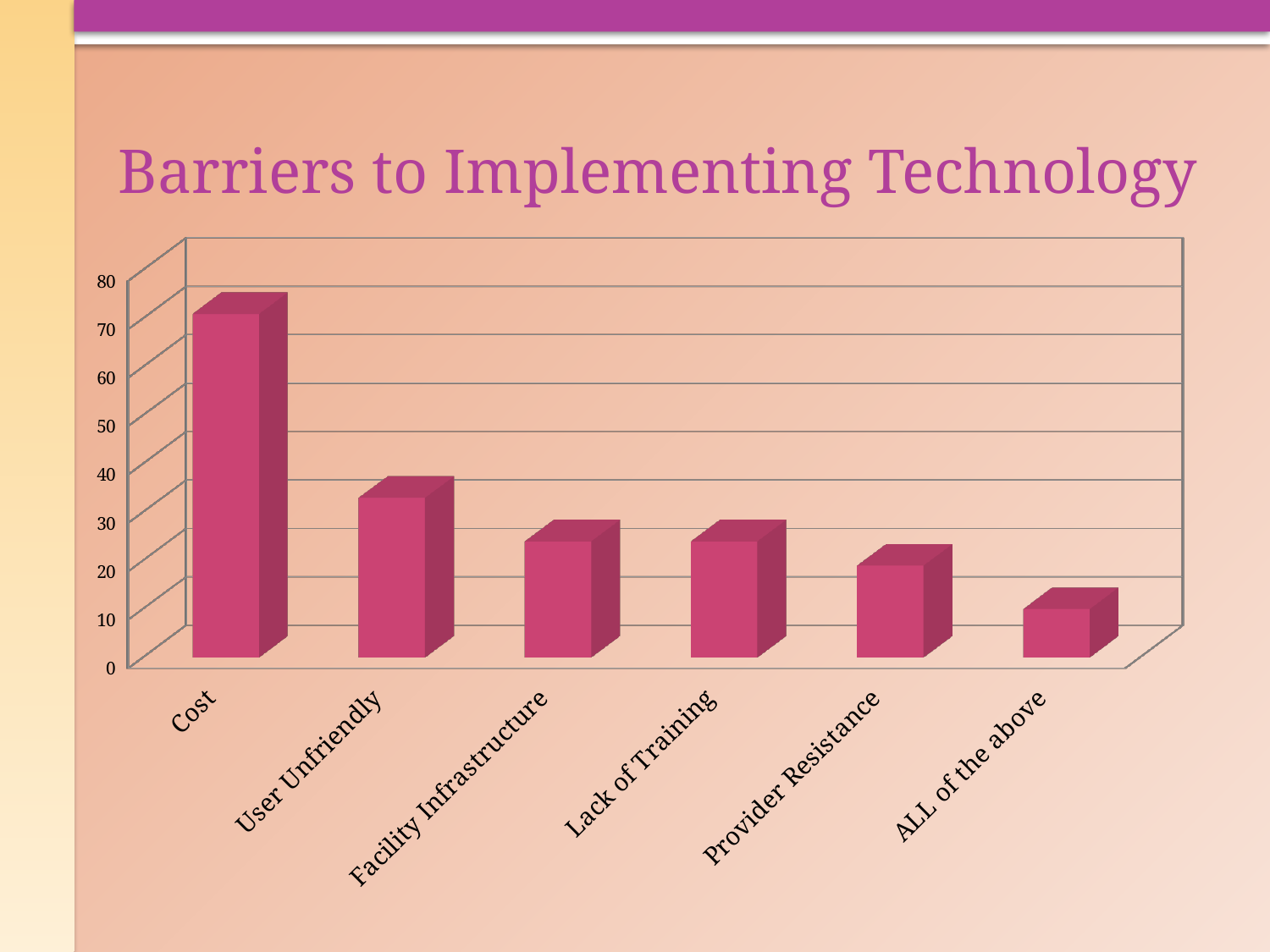
Which category has the lowest value? ALL of the above Is the value for Cost greater or less than 60? greater How many categories are plotted in the chart? 6 Is the value for Facility Infrastructure greater or less than 40? less Is the value for Provider Resistance greater or less than 30? less What kind of chart is shown on the slide? bar chart Which category has the highest value? Cost What is the title of the chart? Barriers to Implementing Technology Do the values generally rise or fall from left to right across the categories? fall Which is larger, the value for User Unfriendly or the value for Provider Resistance? User Unfriendly